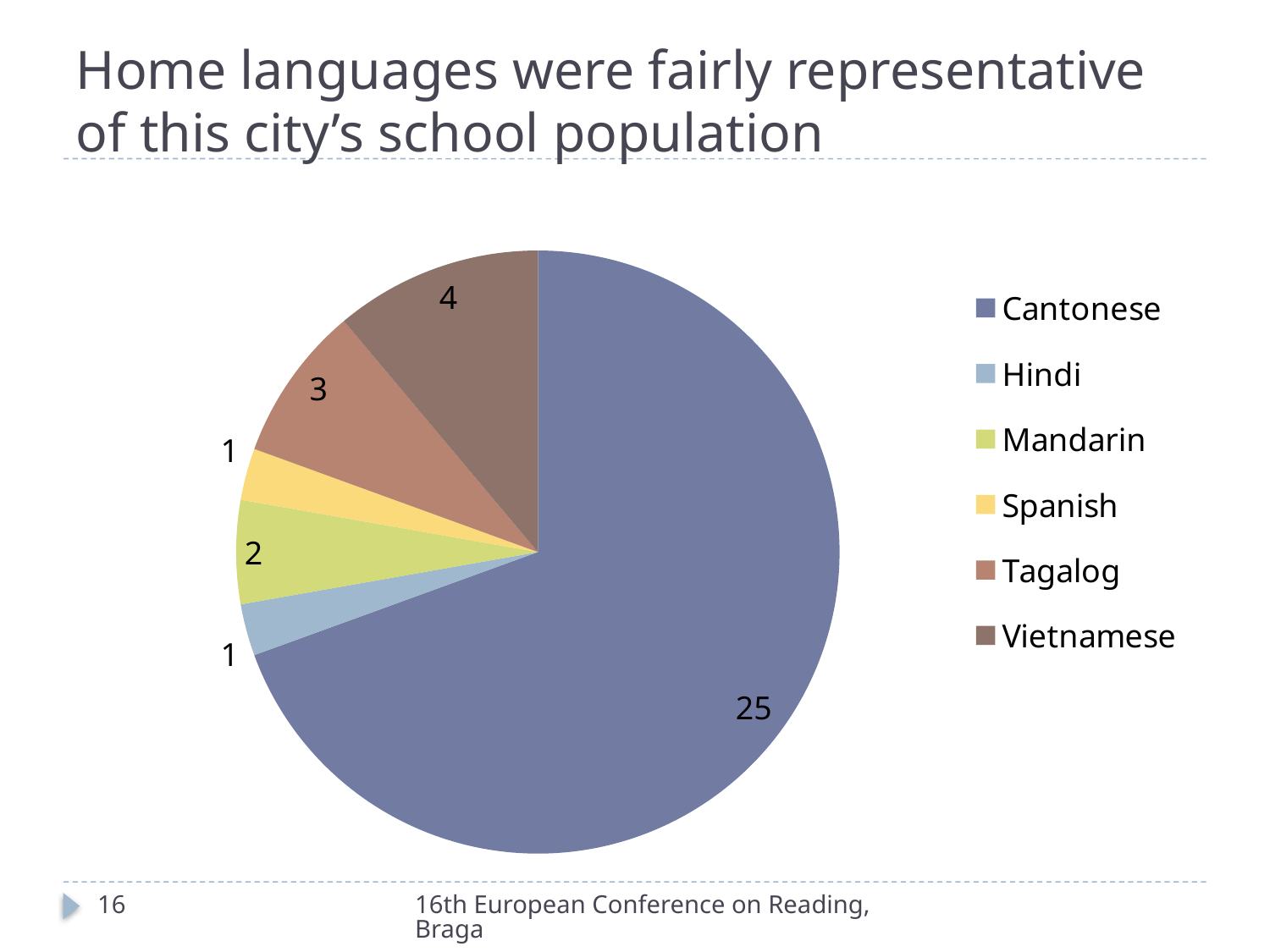
Which home language has the largest slice of the pie? Cantonese What is the total of all the slice values in the pie chart? 36 Which is larger, the Tagalog slice or the Mandarin slice? Tagalog What value is shown for the Vietnamese slice? 4 What value is shown for the Hindi slice? 1 What is the difference between the Cantonese value and the Vietnamese value? 21 What value is shown for the Mandarin slice? 2 How many home languages are shown in the pie chart? 6 What colour is the Spanish slice in the pie chart? Yellow What kind of chart is shown on the slide? Pie chart What value is shown for the Tagalog slice? 3 What value is shown for the Cantonese slice? 25